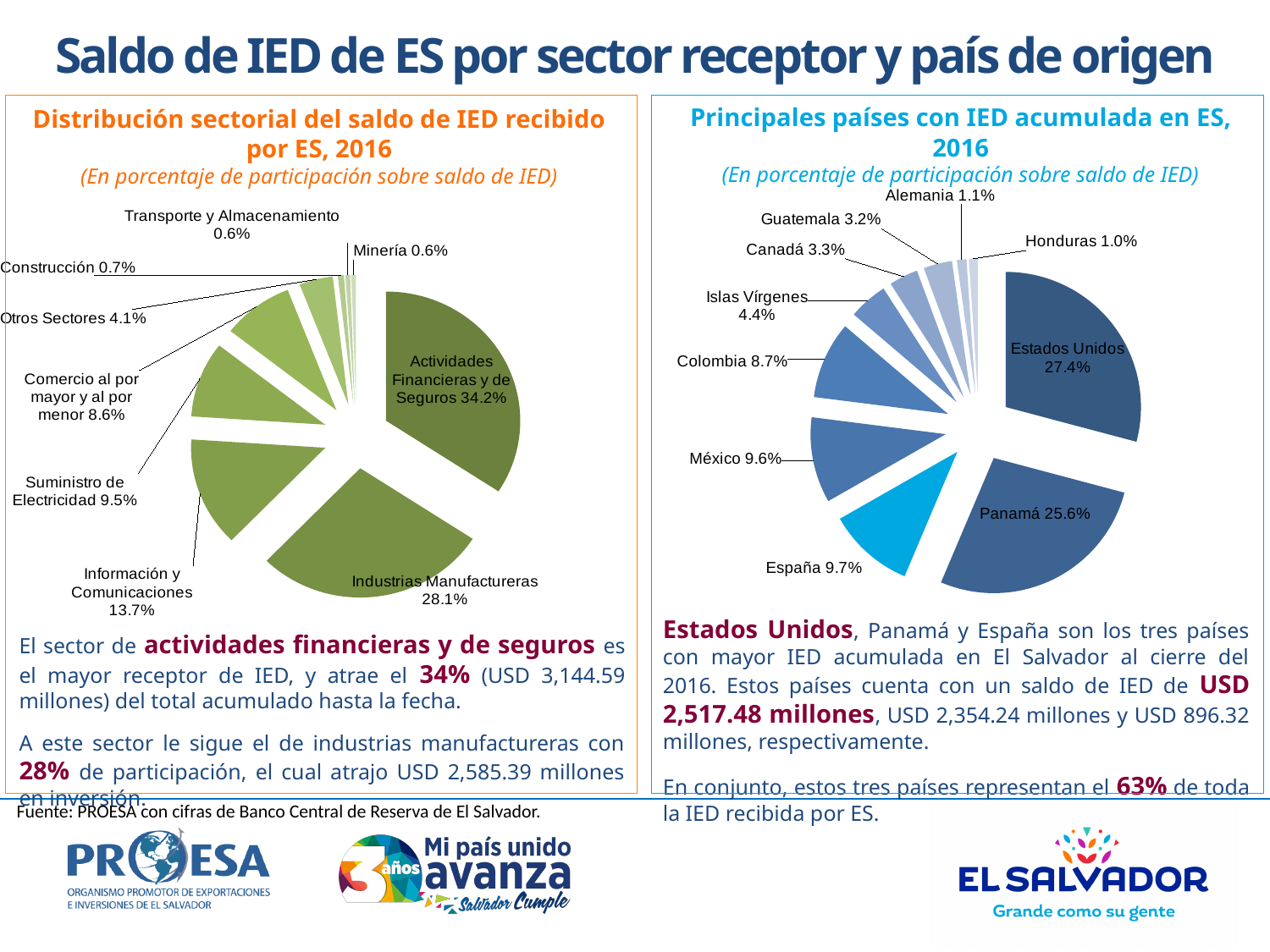
On the right chart (Principales países), how many countries are shown in the pie? 10 On the left chart (Distribución sectorial), what is the difference in percentage points between Industrias Manufactureras and Suministro de Electricidad? 18.6 On the right chart (Principales países), which country has the largest share? Estados Unidos On the left chart (Distribución sectorial), which is larger: Comercio al por mayor y al por menor or Otros Sectores? Comercio al por mayor y al por menor On the right chart (Principales países), which country has the smallest share? Honduras What type of chart is used on the right side of the slide (Principales países con IED acumulada en ES, 2016)? Pie chart On the left chart (Distribución sectorial), which sector has the largest share? Actividades Financieras y de Seguros On the left chart (Distribución sectorial del saldo de IED recibido por ES, 2016), what share does Actividades Financieras y de Seguros have? 34.2% On the right chart (Principales países con IED acumulada en ES, 2016), what share does Panamá have? 25.6% On the left chart (Distribución sectorial), how many sectors are shown in the pie? 9 On the left chart (Distribución sectorial), what is the share for Información y Comunicaciones? 13.7% On the right chart (Principales países), what is the difference in percentage points between Estados Unidos and Panamá? 1.8